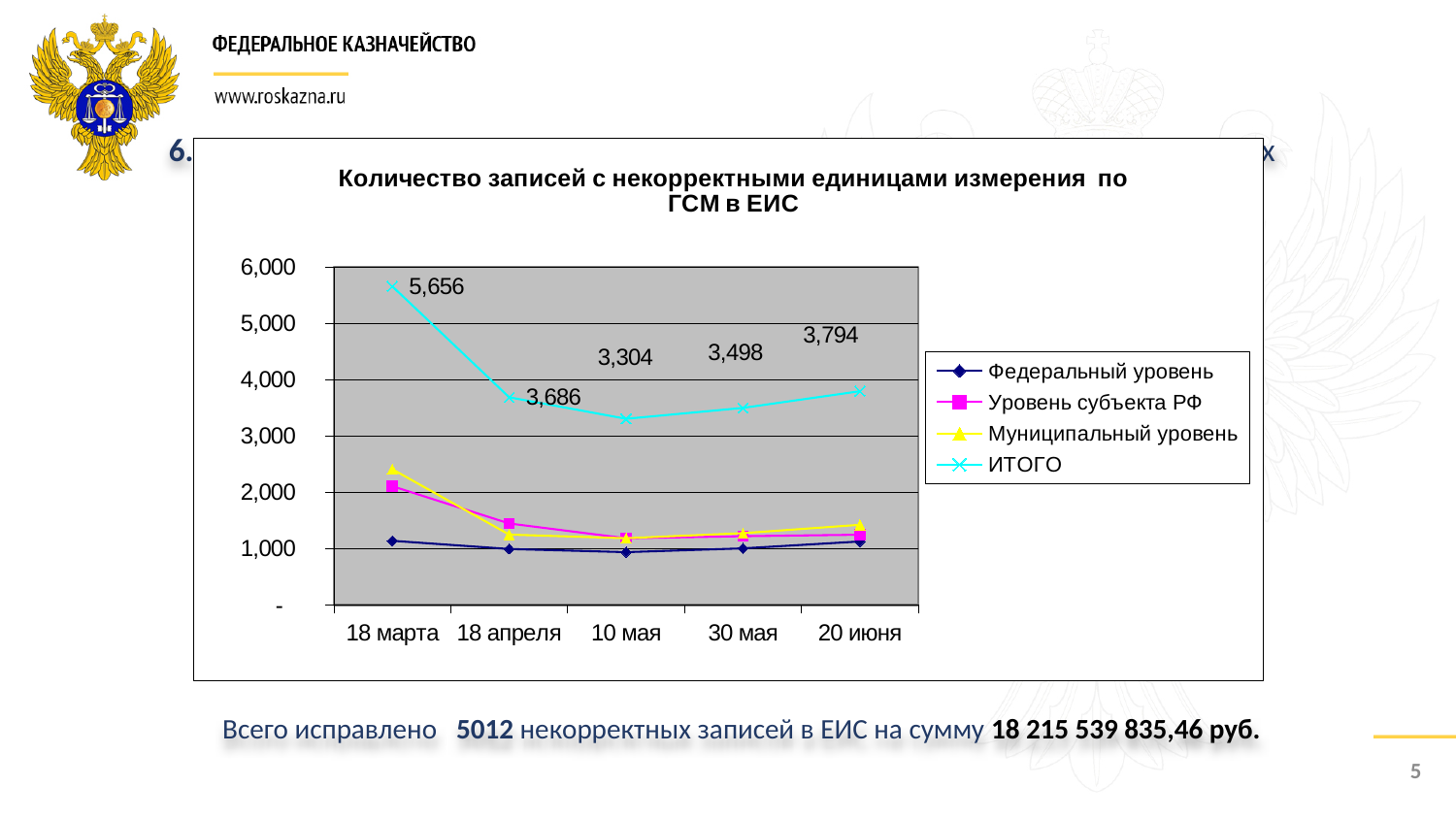
What is the value of the ИТОГО series on 18 марта? 5,656 Does the ИТОГО series rise or fall between 18 марта and 10 мая? fall Is the value of the Муниципальный уровень series on 18 марта greater or less than 2,000? greater On which date is the ИТОГО series at its highest? 18 марта Which is larger for the ИТОГО series: the value on 30 мая or on 20 июня? 20 июня On which date is the ИТОГО series at its lowest? 10 мая What is the value of the ИТОГО series on 20 июня? 3,794 What is the value of the ИТОГО series on 10 мая? 3,304 What type of chart is shown on the slide? line chart How many series does the legend list? 4 How many dates are shown on the x axis? 5 What is the difference between the ИТОГО values on 18 марта and 18 апреля? 1,970